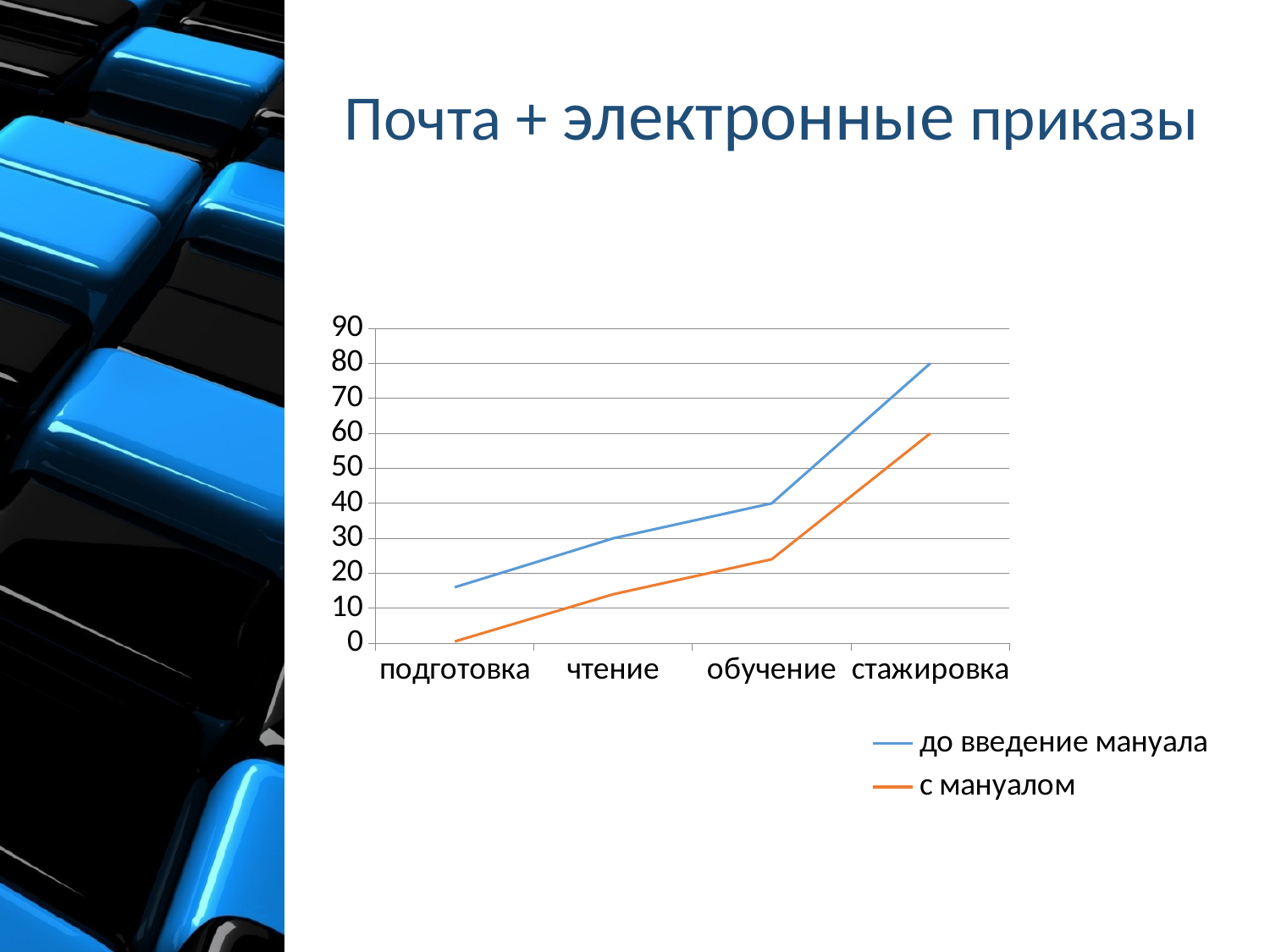
Is the value for подготовка in the series до введение мануала greater or less than 20? less What is the value for стажировка in the series с мануалом? 60 How many series does the legend list? 2 Which category has the lowest value in the series до введение мануала? подготовка Is the value for обучение in the series с мануалом greater or less than 30? less Do the values in the series с мануалом rise or fall from подготовка to стажировка? rise Which series has the larger value for чтение, до введение мануала or с мануалом? до введение мануала What is the value for стажировка in the series до введение мануала? 80 How many categories are shown on the x axis? 4 Which category has the highest value in the series с мануалом? стажировка What is the value for обучение in the series до введение мануала? 40 What kind of chart is shown on the slide? line chart